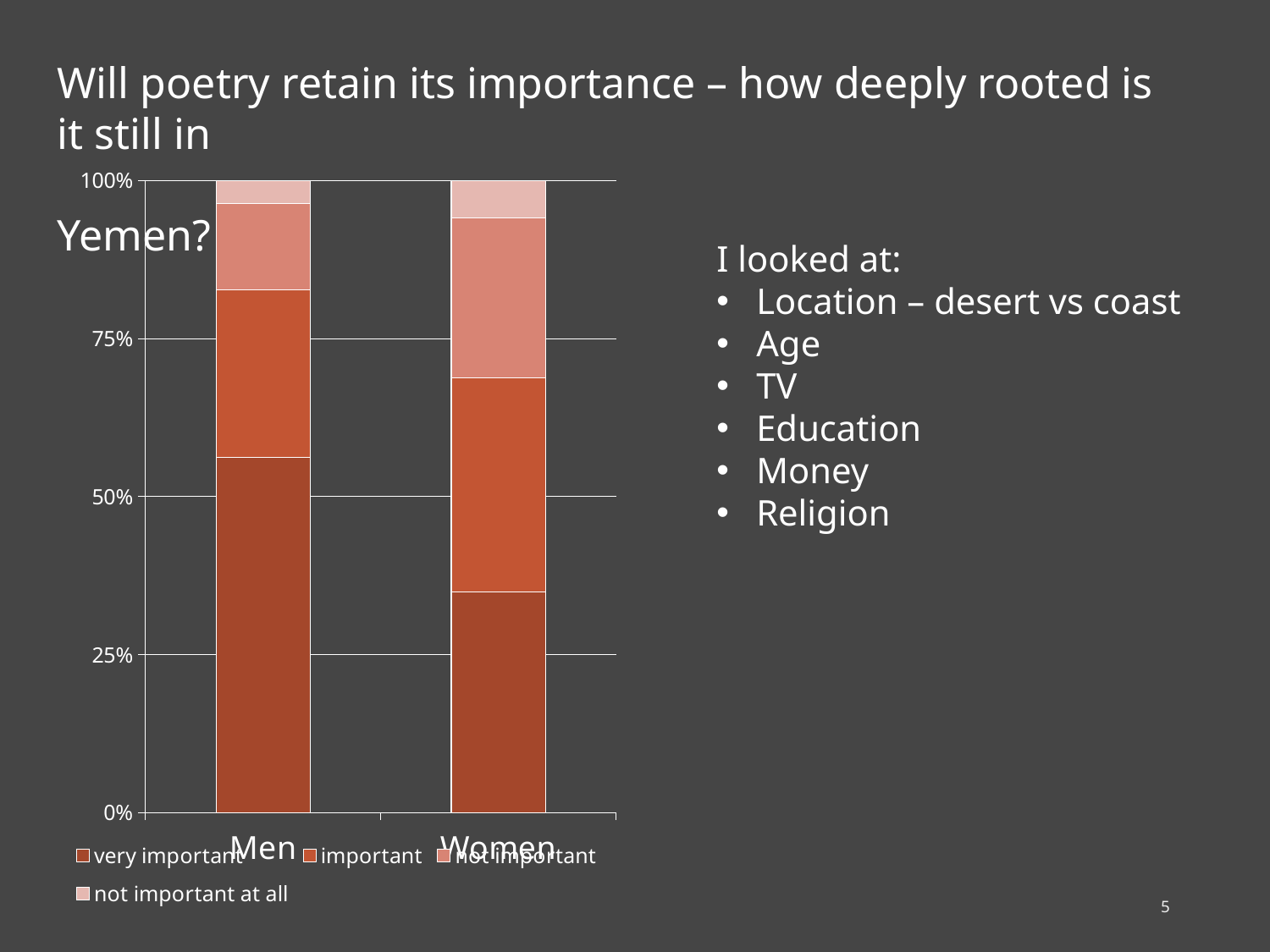
Which two categories are plotted on the x axis? Men and Women Is the 'very important' share for Women greater or less than 25%? greater Which category has the larger 'very important' share, Men or Women? Men Which series forms the largest segment of the Men bar? very important Is the 'very important' share for Women greater or less than 50%? less What is the total height of each stacked bar according to the y axis? 100% What is the last entry listed in the chart's legend? not important at all Is the 'very important' share for Men greater or less than 50%? greater How many categories are shown on the x axis of the chart? 2 How many series does the chart's legend list? 4 Which category has the larger 'not important' share, Men or Women? Women What kind of chart is shown on the slide? stacked bar chart